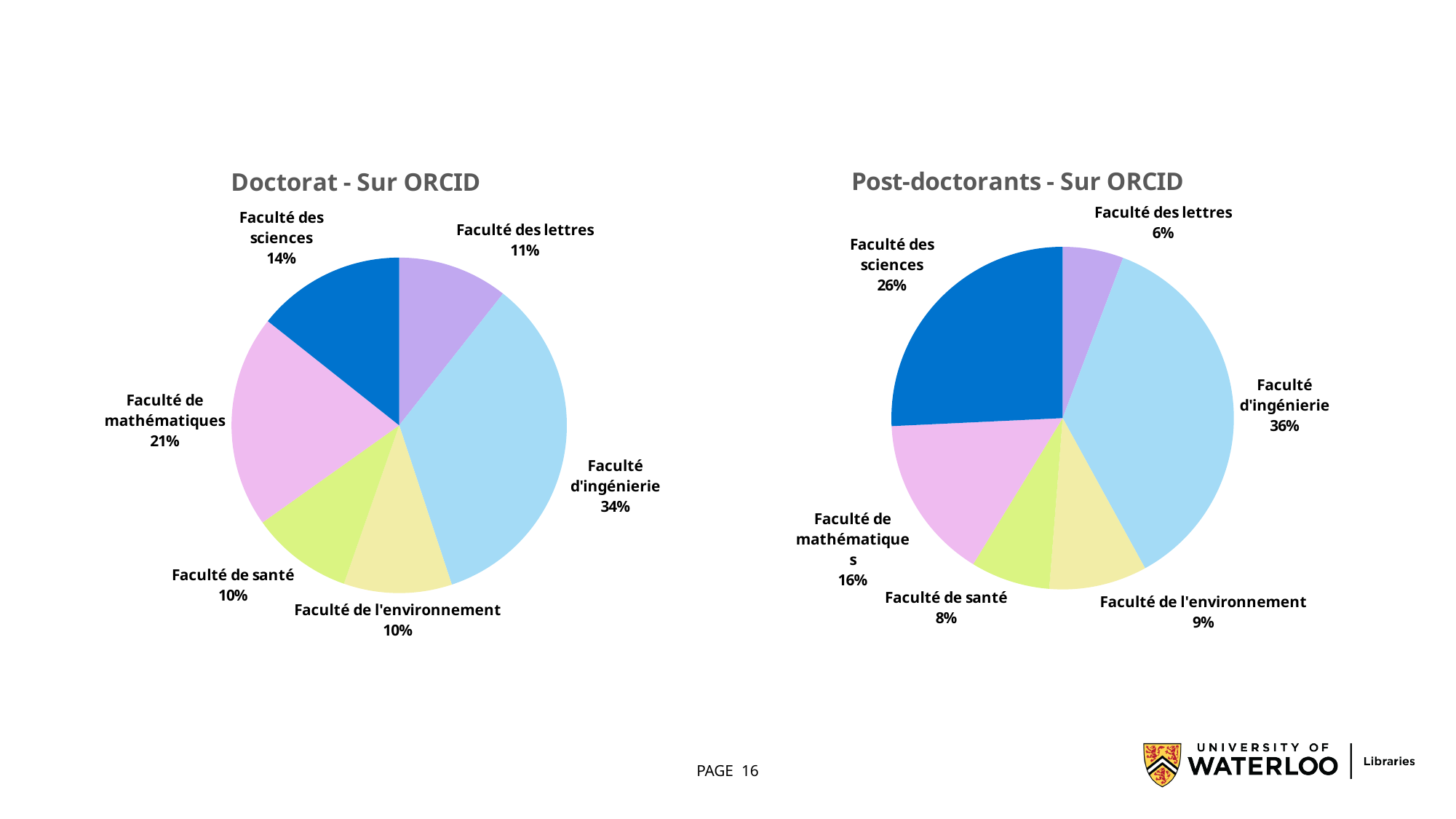
In the 'Doctorat - Sur ORCID' chart, what share does Faculté des lettres have? 11% In the 'Post-doctorants - Sur ORCID' chart, what share does Faculté de l'environnement have? 9% What is the title of the chart on the left side of the slide? Doctorat - Sur ORCID In the 'Doctorat - Sur ORCID' chart, which faculty has the largest slice? Faculté d'ingénierie What type of chart is 'Post-doctorants - Sur ORCID'? Pie chart In the 'Post-doctorants - Sur ORCID' chart, which is larger: Faculté de mathématiques or Faculté de santé? Faculté de mathématiques In the 'Post-doctorants - Sur ORCID' chart, what is the difference between the shares of Faculté d'ingénierie and Faculté des sciences? 10% In the 'Post-doctorants - Sur ORCID' chart, which faculty has the smallest slice? Faculté des lettres How many slices does the 'Doctorat - Sur ORCID' chart have? 6 In the 'Doctorat - Sur ORCID' chart, what is the difference between the shares of Faculté de mathématiques and Faculté des sciences? 7% In the 'Doctorat - Sur ORCID' chart, what share does Faculté d'ingénierie have? 34%